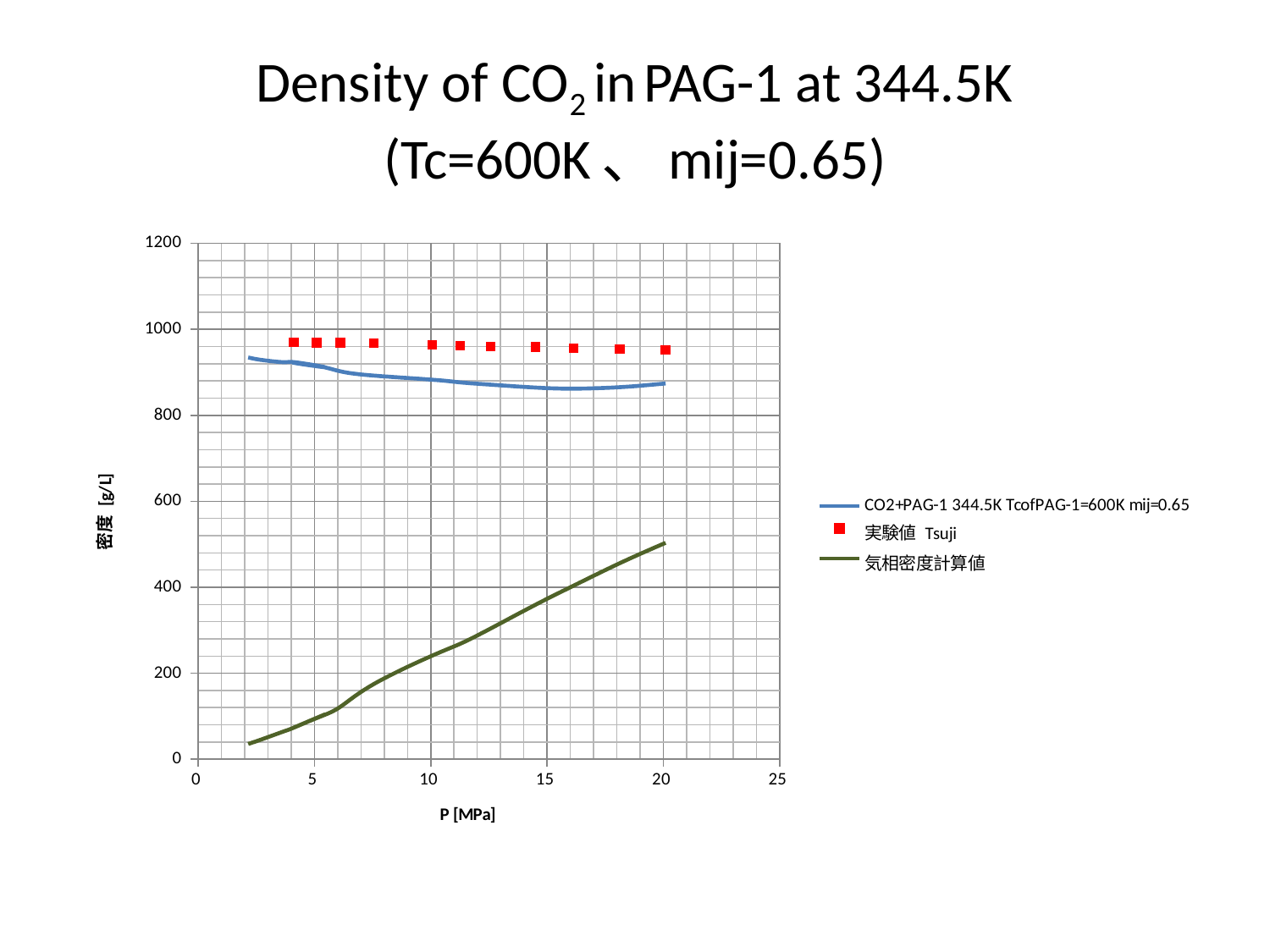
Is the value of the 気相密度計算値 series at 20 MPa greater or less than 600? less Does the 気相密度計算値 series rise or fall as pressure increases? rise At 15 MPa, which is larger: the 実験値 Tsuji value or the CO2+PAG-1 344.5K TcofPAG-1=600K mij=0.65 value? 実験値 Tsuji What is the label of the x axis? P [MPa] Which series has the lowest values across the plotted pressure range? 気相密度計算値 Is the value of the CO2+PAG-1 344.5K TcofPAG-1=600K mij=0.65 series at 10 MPa greater or less than 800? greater What kind of chart is shown on the slide? line chart What is the label of the y axis? 密度 [g/L] How many series does the legend list? 3 Are the 実験値 Tsuji points greater or less than 1000? less Does the CO2+PAG-1 344.5K TcofPAG-1=600K mij=0.65 series rise or fall between 5 MPa and 15 MPa? fall